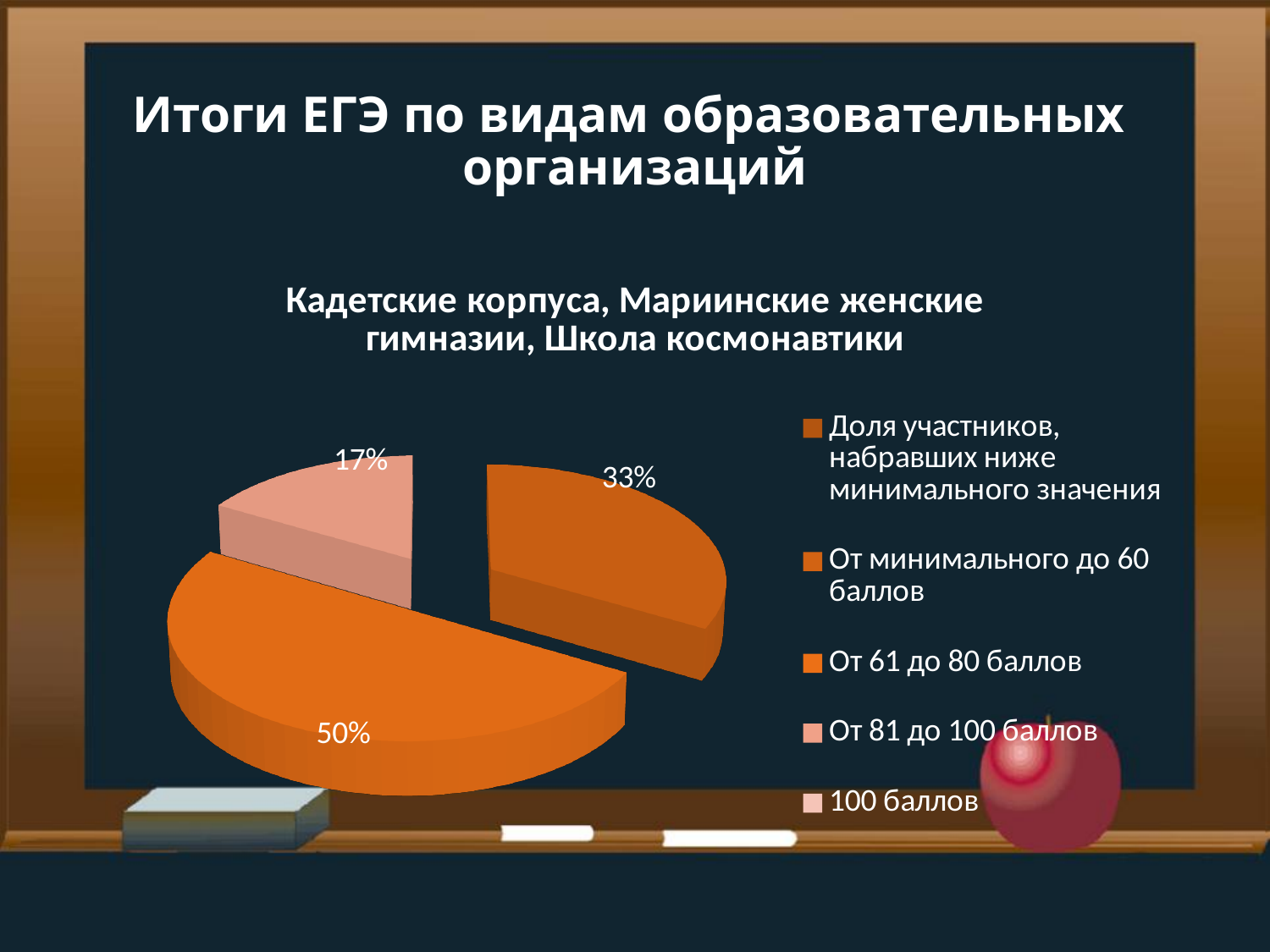
What is the difference between the 50% slice and the 33% slice? 17 percentage points What is the value of the largest slice of the pie? 50% What is the last entry in the legend? 100 баллов How many entries does the legend list? 5 What kind of chart is shown on the slide? Pie chart Which is larger, the slice labelled 33% or the slice labelled 17%? 33% What is the value of the smallest labelled slice of the pie? 17% How many slices with data labels are visible in the pie? 3 What is the difference between the 50% slice and the 17% slice? 33 percentage points What do the three labelled slices add up to? 100% What is the title of the chart? Кадетские корпуса, Мариинские женские гимназии, Школа космонавтики